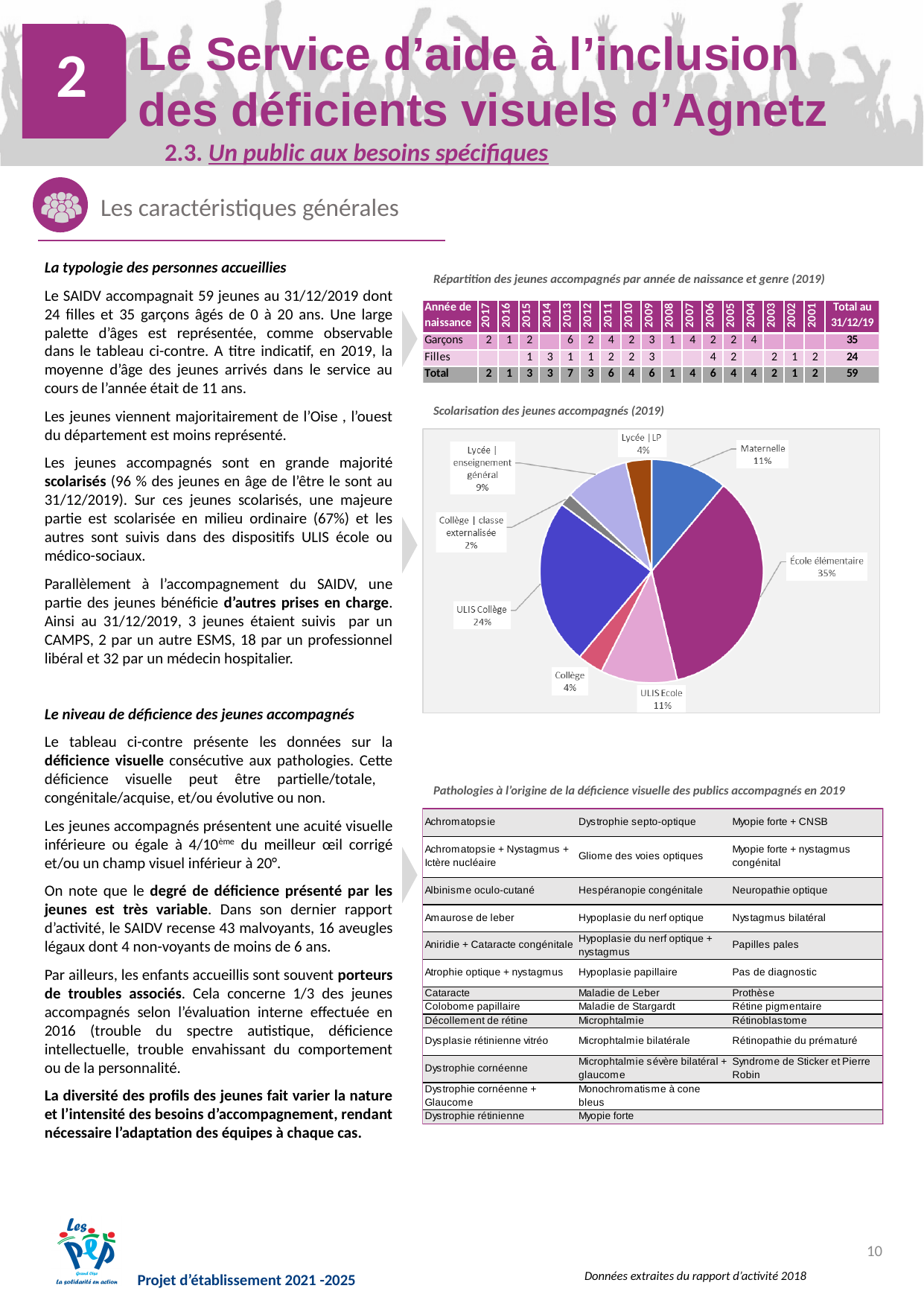
In the pie chart 'Scolarisation des jeunes accompagnés (2019)', what is the difference in percentage points between École élémentaire and ULIS Collège? 11 In the pie chart 'Scolarisation des jeunes accompagnés (2019)', which category has the smallest share? Collège | classe externalisée How many categories does the pie chart 'Scolarisation des jeunes accompagnés (2019)' show? 8 In the pie chart 'Scolarisation des jeunes accompagnés (2019)', what share is ULIS Collège? 24% In the pie chart 'Scolarisation des jeunes accompagnés (2019)', which is larger: Maternelle or Lycée | enseignement général? Maternelle In the pie chart 'Scolarisation des jeunes accompagnés (2019)', what share is Collège | classe externalisée? 2% What kind of chart is used for 'Scolarisation des jeunes accompagnés (2019)'? pie chart In the pie chart 'Scolarisation des jeunes accompagnés (2019)', what share is Maternelle? 11% In the pie chart 'Scolarisation des jeunes accompagnés (2019)', what share is Lycée | enseignement général? 9% In the pie chart 'Scolarisation des jeunes accompagnés (2019)', which category has the largest share? École élémentaire In the pie chart 'Scolarisation des jeunes accompagnés (2019)', what share is École élémentaire? 35% In the pie chart 'Scolarisation des jeunes accompagnés (2019)', what is the combined share of ULIS Ecole and ULIS Collège? 35%